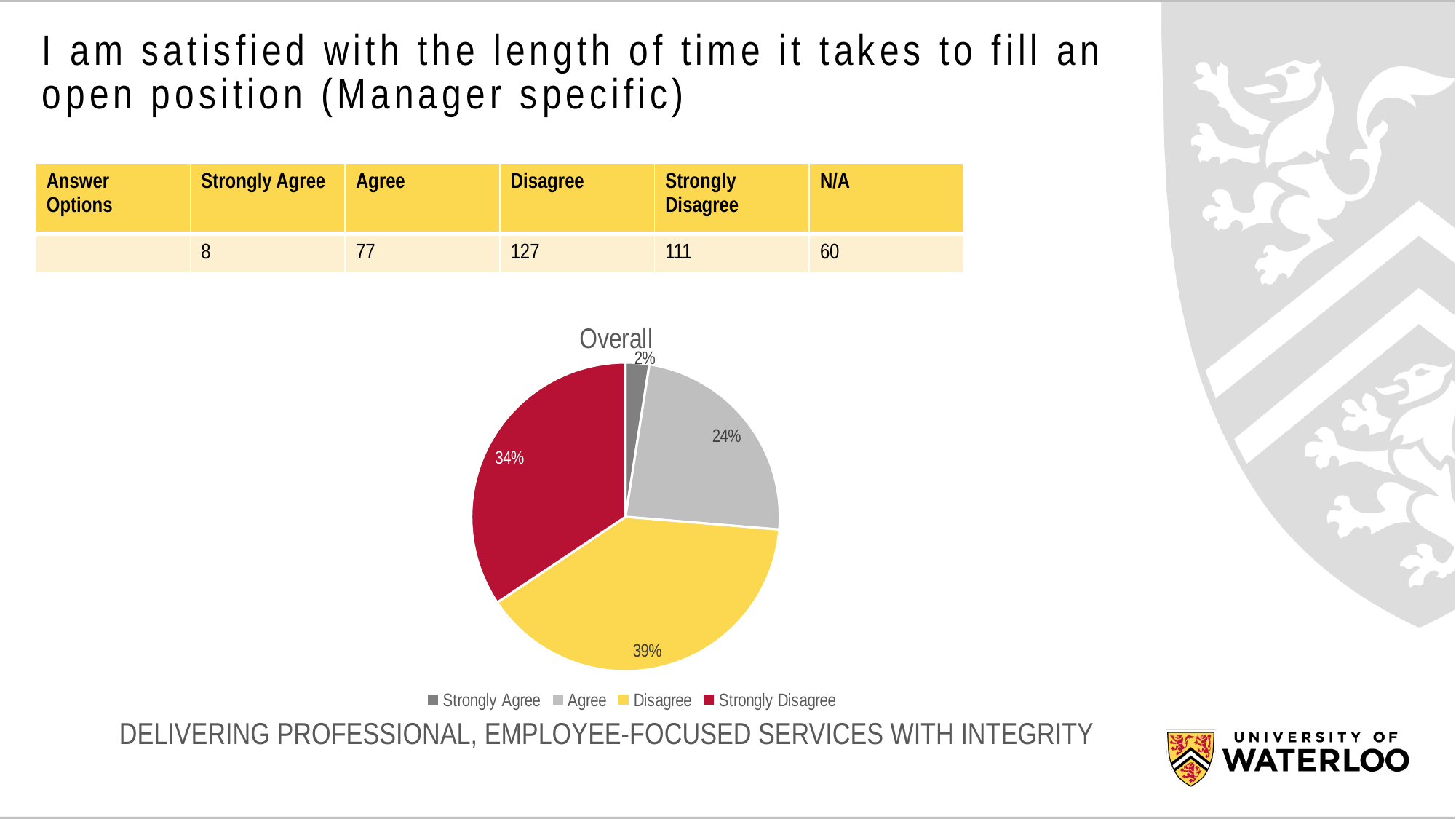
How many categories does the legend of the pie chart list? 4 What is the title of the pie chart? Overall What is the difference in percentage points between the Disagree and Agree slices? 15 Which slice is larger, Agree or Strongly Disagree? Strongly Disagree What percentage of the pie does the Strongly Disagree slice represent? 34% What percentage of the pie does the Strongly Agree slice represent? 2% What kind of chart is shown on the slide? pie chart Which category has the largest slice of the pie? Disagree Which category has the smallest slice of the pie? Strongly Agree What colour is the Strongly Disagree slice in the pie chart? red What percentage of the pie does the Agree slice represent? 24%